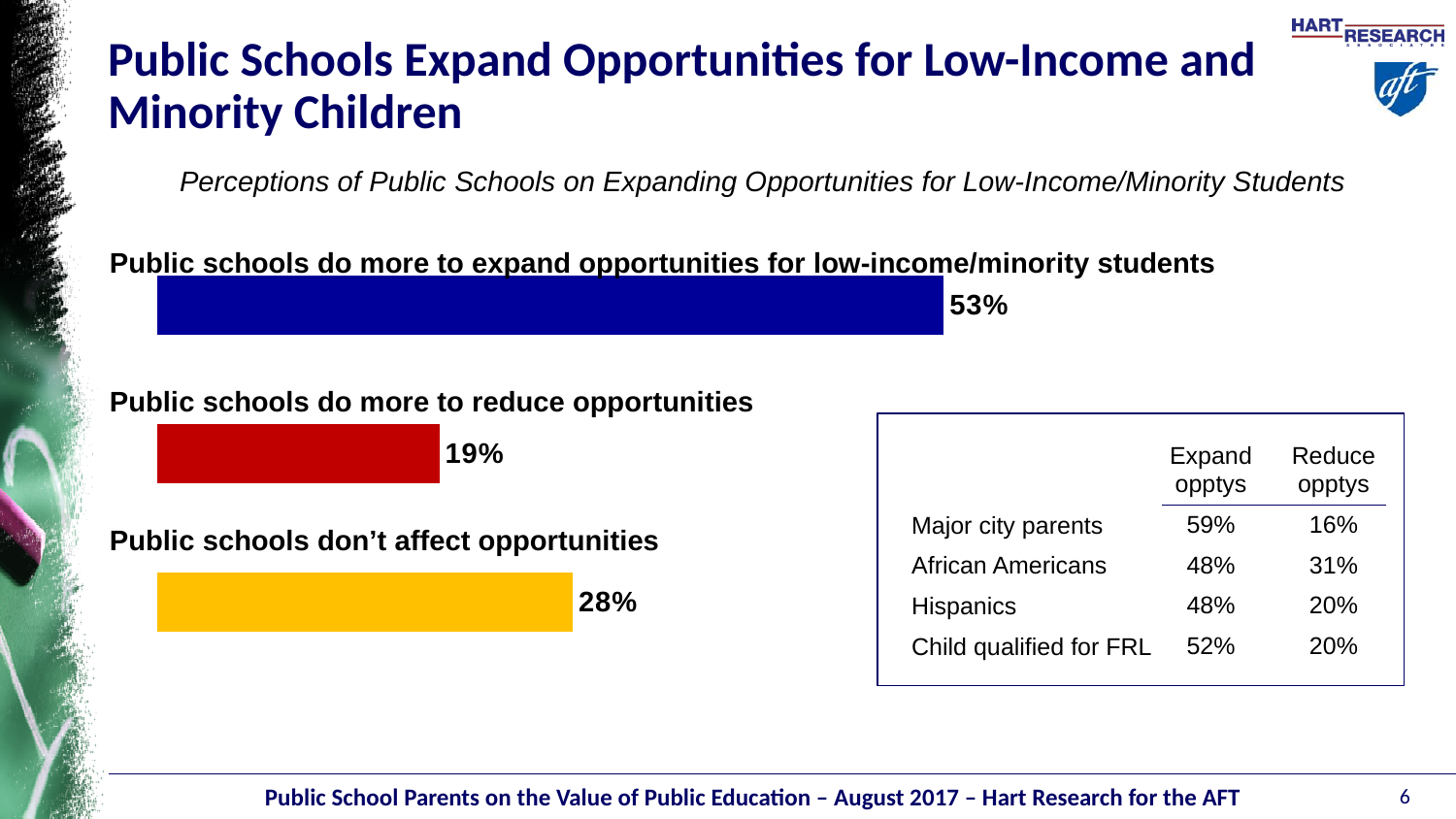
What is the subtitle of the chart? Perceptions of Public Schools on Expanding Opportunities for Low-Income/Minority Students Which response has the lowest percentage in the bar chart? Public schools do more to reduce opportunities What percentage say public schools don't affect opportunities? 28% Which response has the highest percentage in the bar chart? Public schools do more to expand opportunities for low-income/minority students What is the difference between the percentage saying public schools expand opportunities and the percentage saying they reduce opportunities? 34 percentage points What percentage of respondents say public schools do more to expand opportunities for low-income/minority students? 53% What colour is the bar for 'Public schools do more to reduce opportunities'? Red How many bars are shown in the bar chart? 3 Which is larger: the percentage saying public schools don't affect opportunities or the percentage saying they reduce opportunities? Public schools don't affect opportunities What is the difference between the percentage saying public schools don't affect opportunities and the percentage saying they reduce opportunities? 9 percentage points What percentage say public schools do more to reduce opportunities? 19% What type of chart is used to show the perceptions of public schools on expanding opportunities? Bar chart